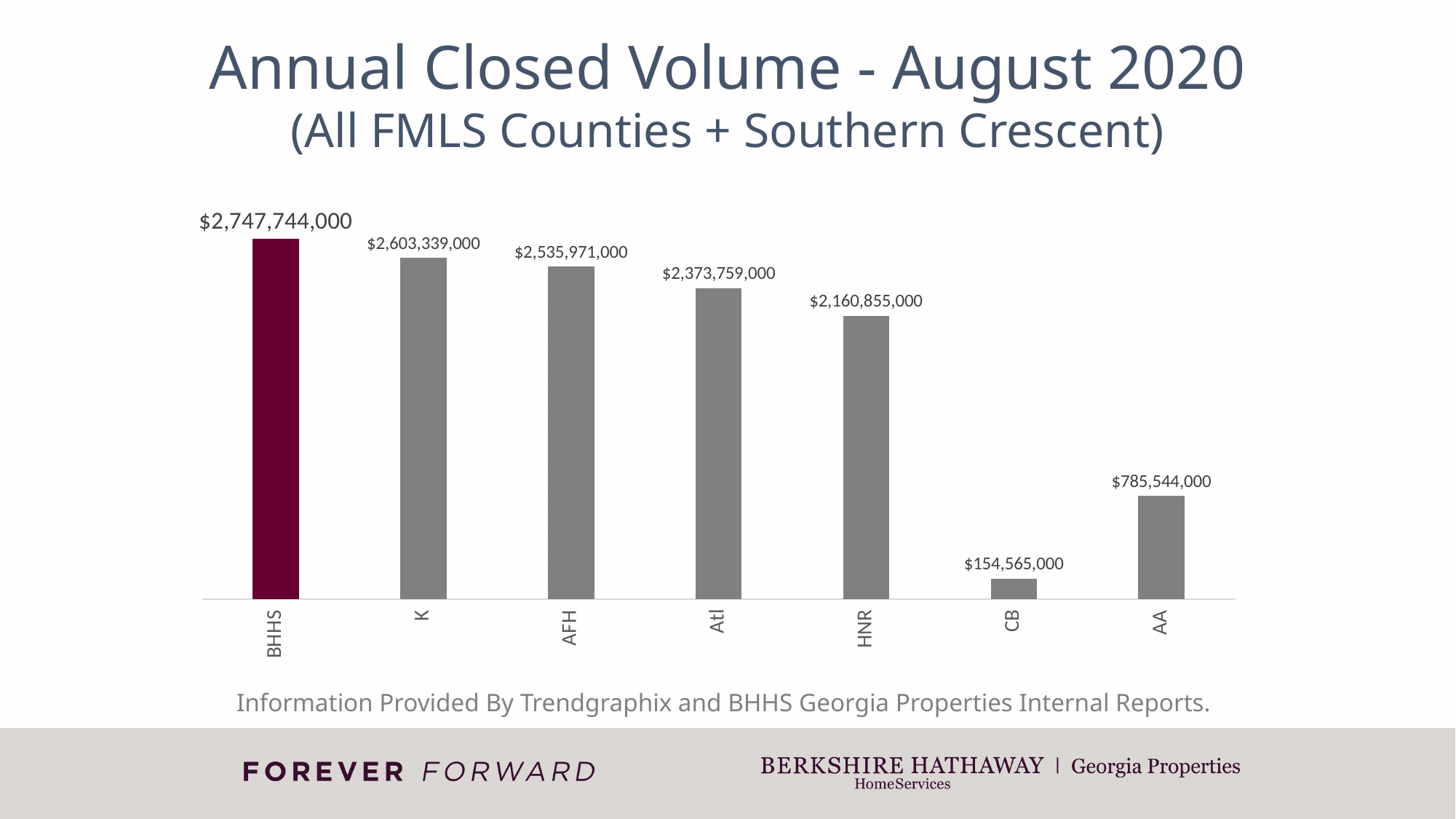
What kind of chart is shown on the slide? Bar chart What is the annual closed volume for Atl? $2,373,759,000 Which has a larger annual closed volume, AFH or HNR? AFH What is the annual closed volume for AA? $785,544,000 How many companies are shown in the chart? 7 What is the difference between the annual closed volume of BHHS and K? $144,405,000 Which company has the lowest annual closed volume? CB Which bar is highlighted in a different colour from the others? BHHS What is the annual closed volume for BHHS? $2,747,744,000 What is the annual closed volume for HNR? $2,160,855,000 What is the difference between the annual closed volume of AA and CB? $630,979,000 Which company has the highest annual closed volume? BHHS